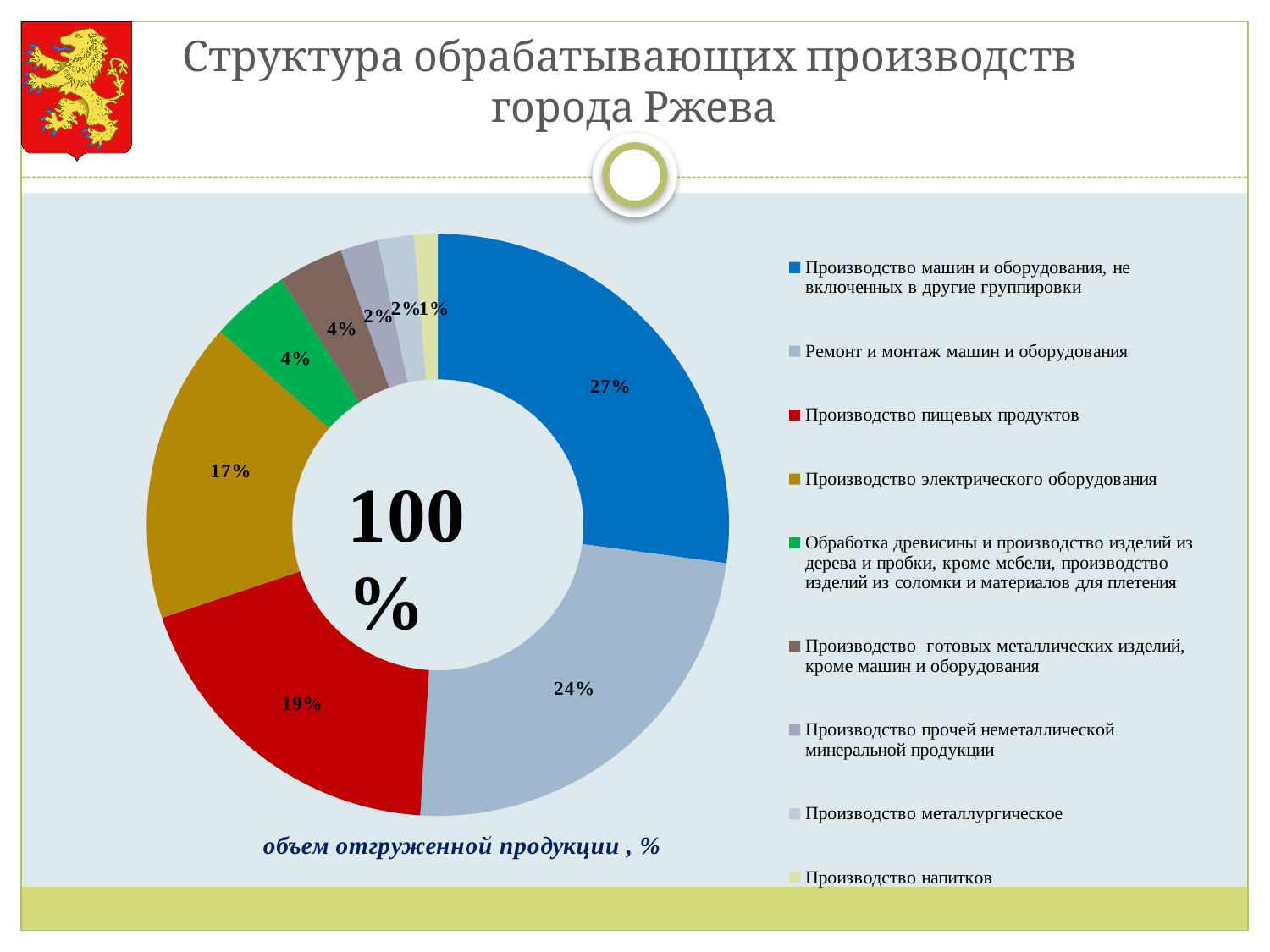
What kind of chart is shown on the slide? Doughnut (pie) chart Which is larger: the share of "Ремонт и монтаж машин и оборудования" or "Производство пищевых продуктов"? Ремонт и монтаж машин и оборудования What share does "Производство пищевых продуктов" have? 19% Which category has the smallest share? Производство напитков How many categories does the legend list? 9 What share does "Производство электрического оборудования" have? 17% What is the difference between the shares of "Производство пищевых продуктов" and "Производство электрического оборудования"? 2% What share does "Производство напитков" have? 1% What share does "Производство машин и оборудования, не включенных в другие группировки" have? 27% What share does "Ремонт и монтаж машин и оборудования" have? 24% Which category has the largest share? Производство машин и оборудования, не включенных в другие группировки What text is shown in the centre of the doughnut chart? 100 %